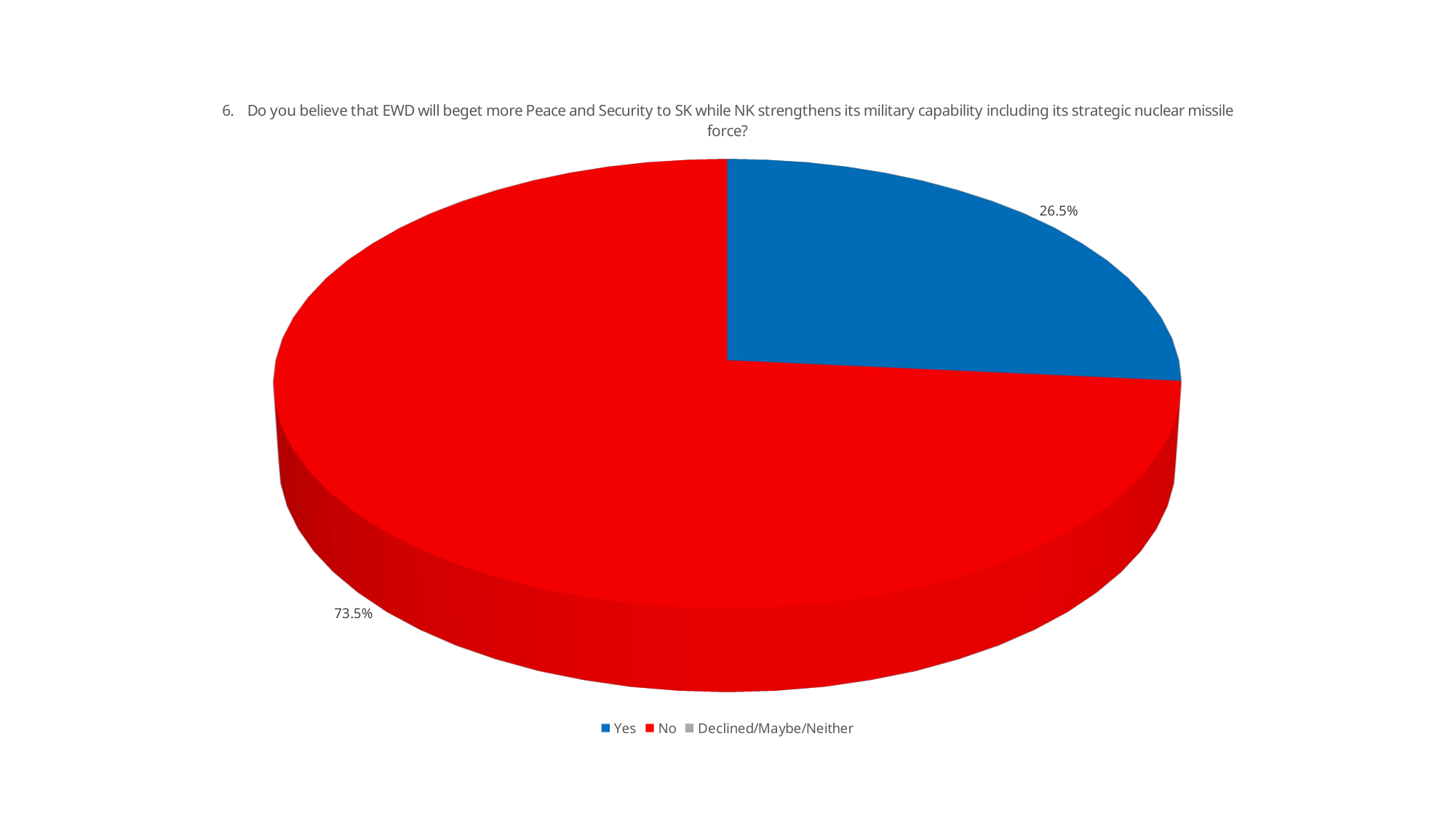
What is the difference in percentage points between the No slice and the Yes slice? 47 percentage points Which slice is larger, Yes or No? No What colour is the "No" slice? Red What share of the pie is labelled for the "No" slice? 73.5% Is the share for the Yes slice greater or less than 50%? less What is the third legend entry, after Yes and No? Declined/Maybe/Neither How many entries does the legend list? 3 What share of the pie is labelled for the "Yes" slice? 26.5% What kind of chart is shown on the slide? Pie chart How many slices are visible in the pie? 2 Which of the two visible slices, Yes or No, is smaller? Yes Which response has the largest slice of the pie? No